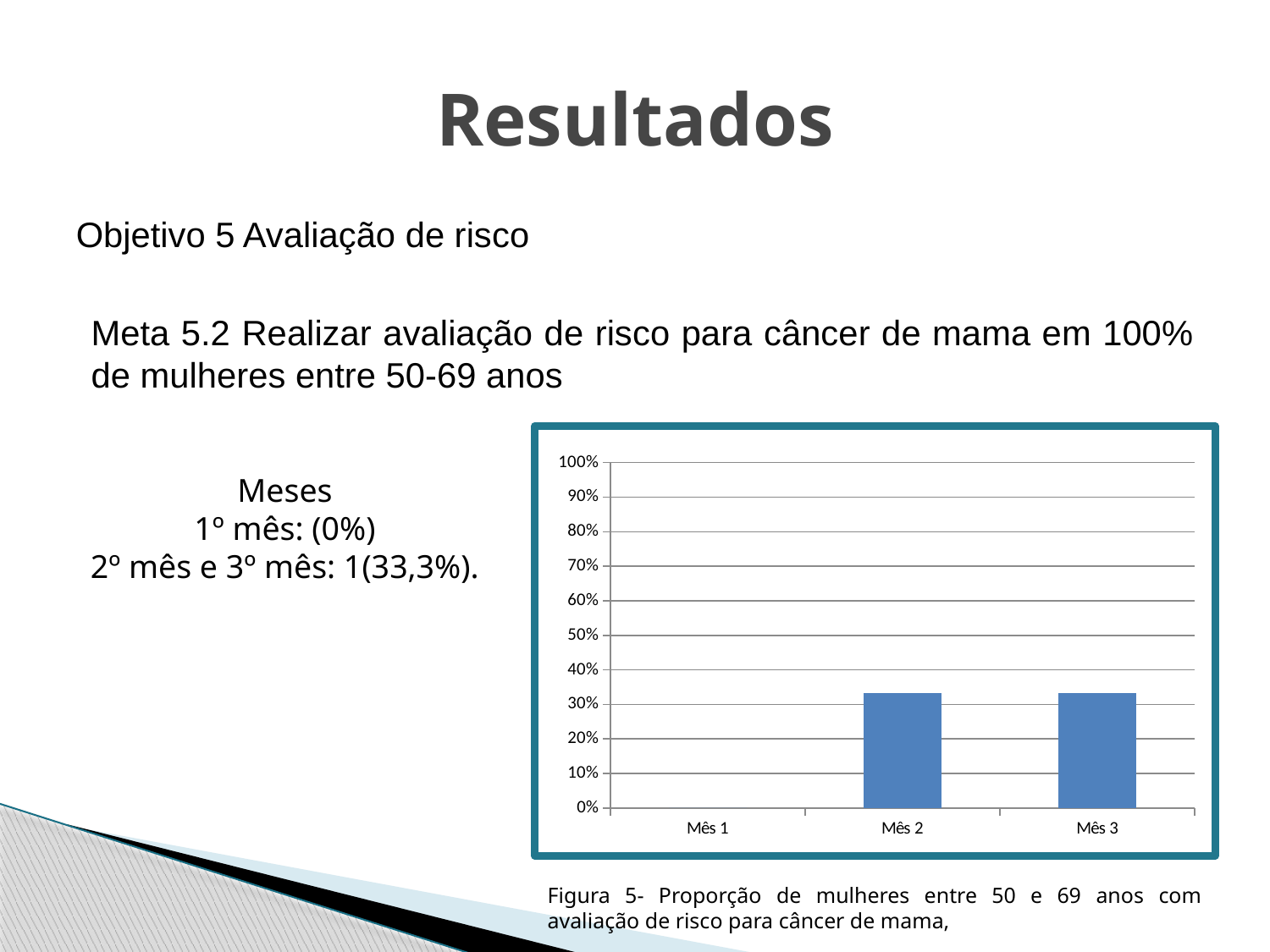
Is the value for Mês 2 greater or less than 50%? less How many categories are shown on the x axis of the chart? 3 What colour are the bars in the chart? blue Which is larger, the value for Mês 1 or the value for Mês 2? Mês 2 What is the value for Mês 1 in the chart? 0% What type of chart is shown on the slide? bar chart Which month has the lowest value in the chart? Mês 1 Is the value for Mês 2 greater or less than 40%? less Is the value for Mês 3 greater or less than 20%? greater What is the highest value shown on the y axis of the chart? 100% Does the value rise or fall from Mês 1 to Mês 2? rise